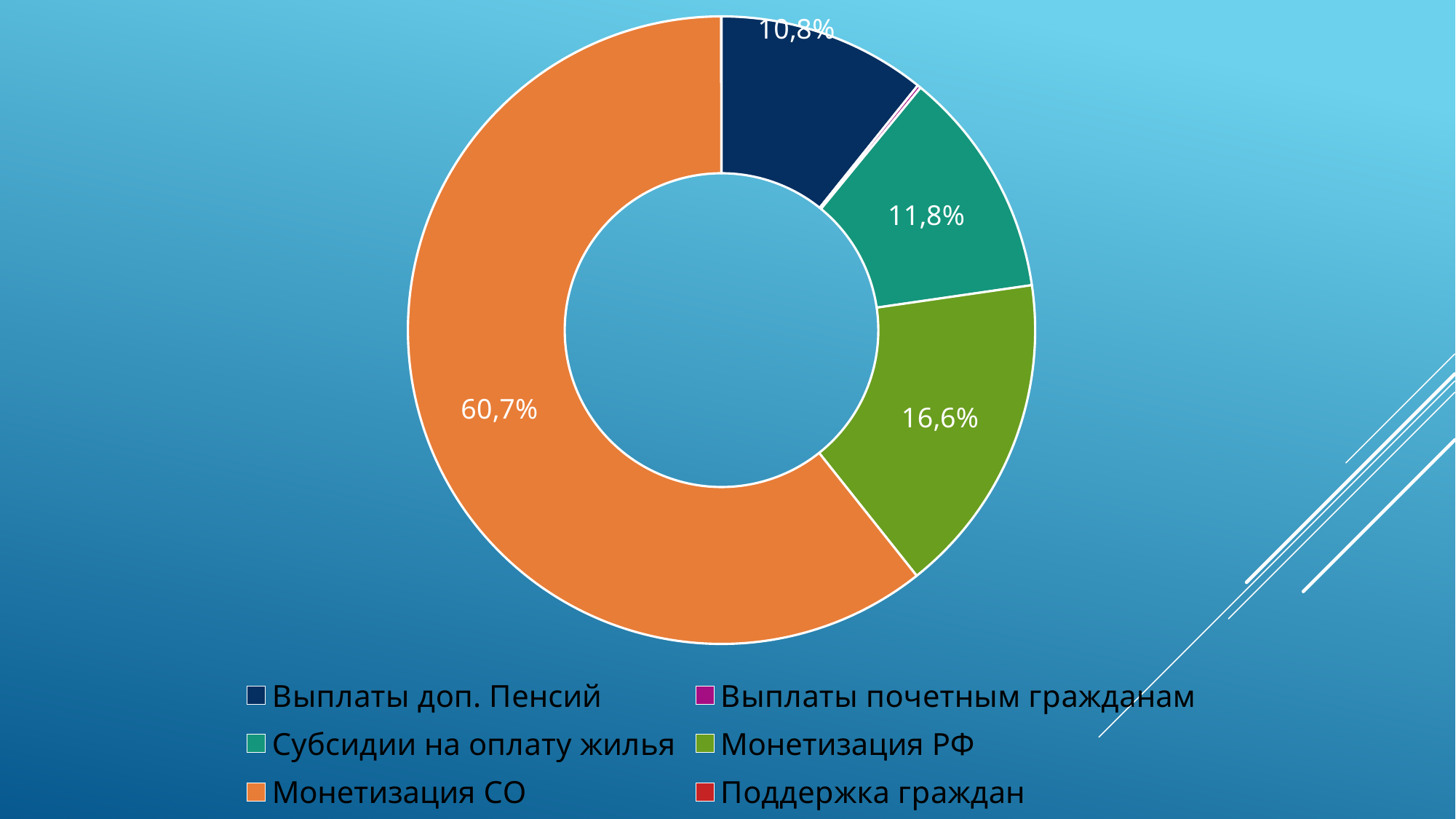
What type of chart is shown on the slide? Doughnut (pie) chart What percentage is shown for Монетизация РФ? 16,6% How many categories does the legend list? 6 Which is larger, the share for Монетизация РФ or the share for Субсидии на оплату жилья? Монетизация РФ Which legend entry is shown in dark navy blue? Выплаты доп. Пенсий What is the difference in percentage points between Монетизация СО and Монетизация РФ? 44,1 What is the difference in percentage points between Монетизация РФ and Субсидии на оплату жилья? 4,8 What percentage is shown for Субсидии на оплату жилья? 11,8% Which category has the largest share of the chart? Монетизация СО What colour is the slice for Монетизация СО? Orange What percentage is shown for Выплаты доп. Пенсий? 10,8% What percentage is shown for Монетизация СО? 60,7%